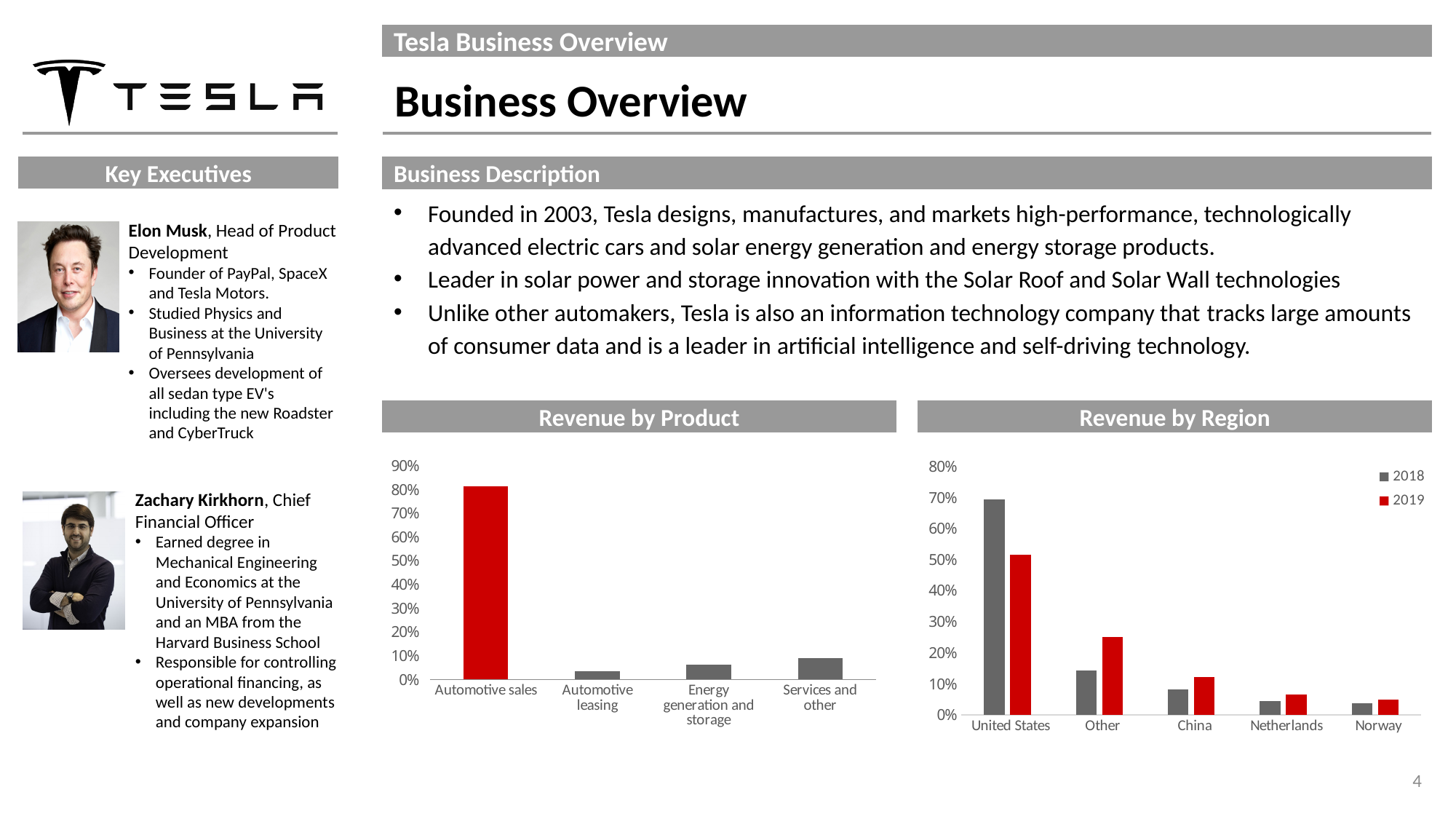
In the Revenue by Region chart, is the 2018 value for United States greater or less than 60%? greater In the Revenue by Product chart, is the value for Services and other greater or less than 20%? less In the Revenue by Product chart, which category has the highest revenue share? Automotive sales In the Revenue by Region chart, which colour represents the 2019 series? red How many series does the legend of the Revenue by Region chart list? 2 What kind of chart is the Revenue by Product chart? bar chart How many regions are shown in the Revenue by Region chart? 5 In the Revenue by Product chart, which is larger: Services and other or Automotive leasing? Services and other In the Revenue by Region chart, which is larger for Other: 2018 or 2019? 2019 In the Revenue by Region chart, which region has the highest 2018 value? United States How many product categories are shown in the Revenue by Product chart? 4